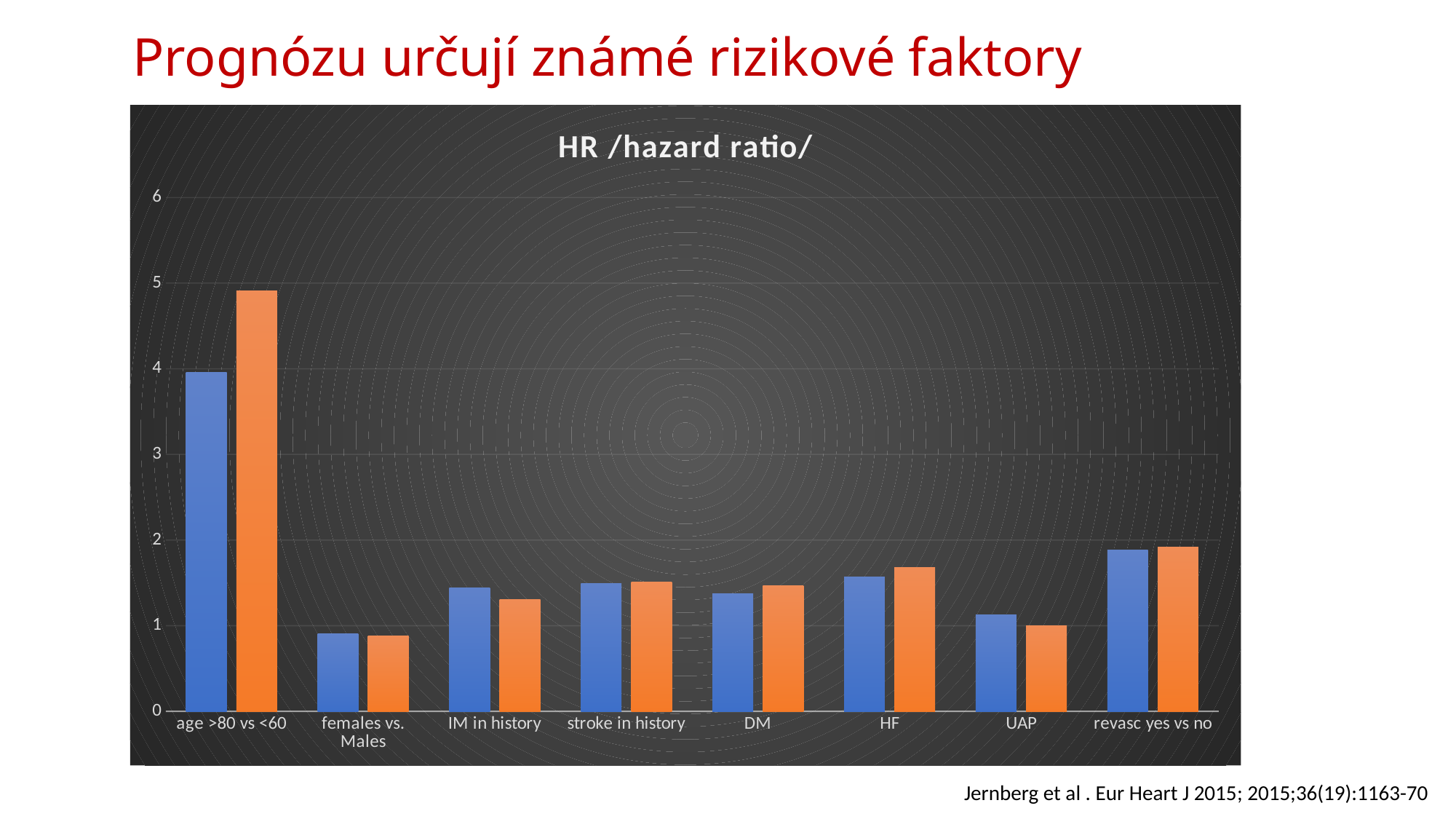
Is the blue bar for 'females vs. Males' greater or less than 1? less How many categories are shown on the x axis of the chart? 8 Is the blue bar for 'revasc yes vs no' greater or less than 2? less Is the blue bar for 'age >80 vs <60' greater or less than 3? greater Which category has the highest bar in the chart? age >80 vs <60 What is the highest value shown on the vertical axis of the chart? 6 For the category 'age >80 vs <60', which bar is taller, the blue one or the orange one? orange What kind of chart is shown on the slide? bar chart What is the title of the chart? HR /hazard ratio/ Which category has the lowest bars in the chart? females vs. Males For the category 'UAP', which bar is taller, the blue one or the orange one? blue